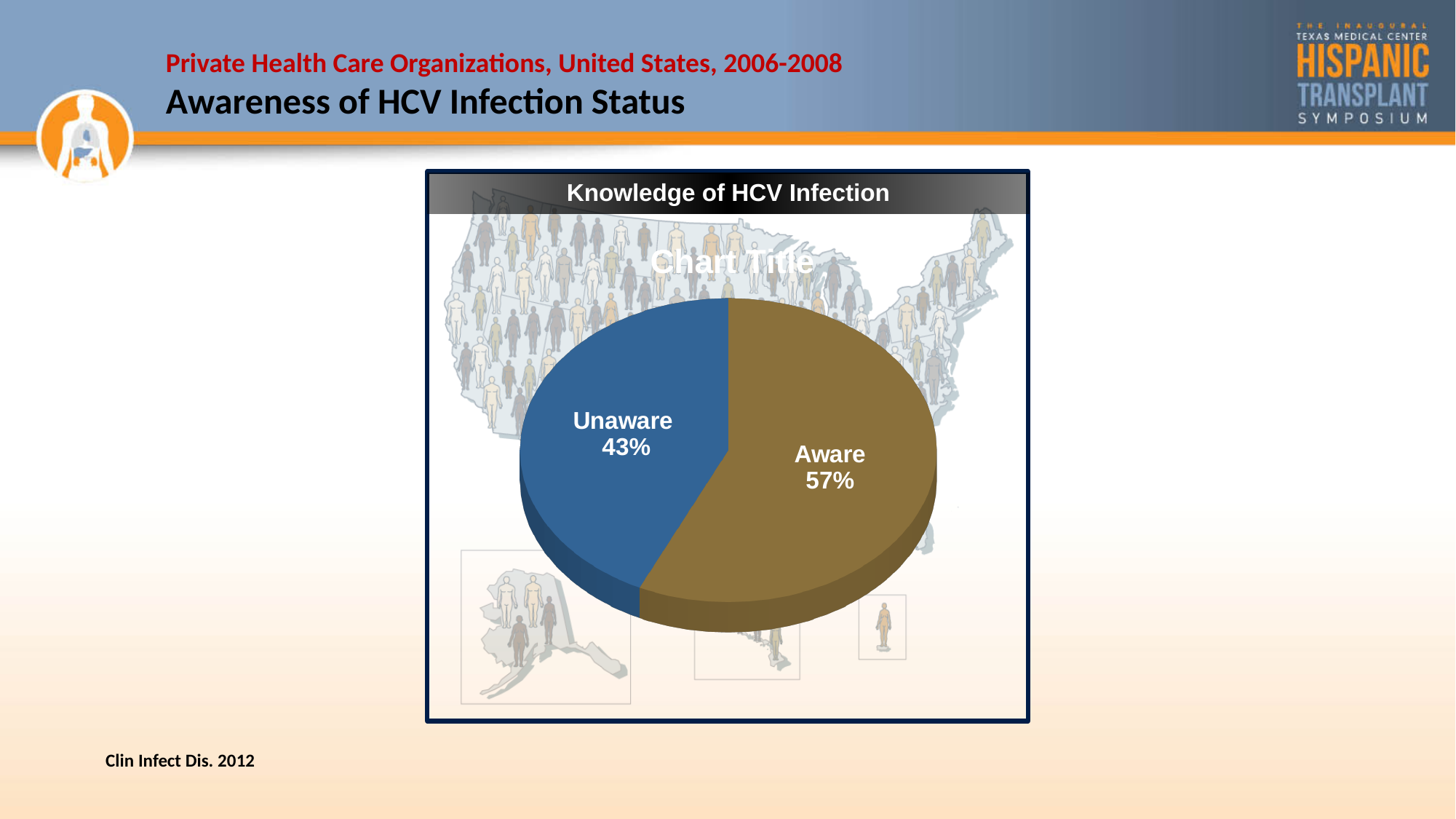
What colour is the Unaware slice of the pie? Blue What percentage of the pie is labelled Aware? 57% Which slice of the pie is the largest? Aware What is the share of the pie taken by the Unaware slice? 43% What is the heading printed above the pie chart? Knowledge of HCV Infection Which slice of the pie is the smallest? Unaware What percentage of the pie is labelled Unaware? 43% Which is larger, the Aware slice or the Unaware slice? Aware What is the difference in percentage points between the Aware and Unaware slices? 14 How many slices does the pie chart have? 2 What kind of chart is shown on the slide? Pie chart